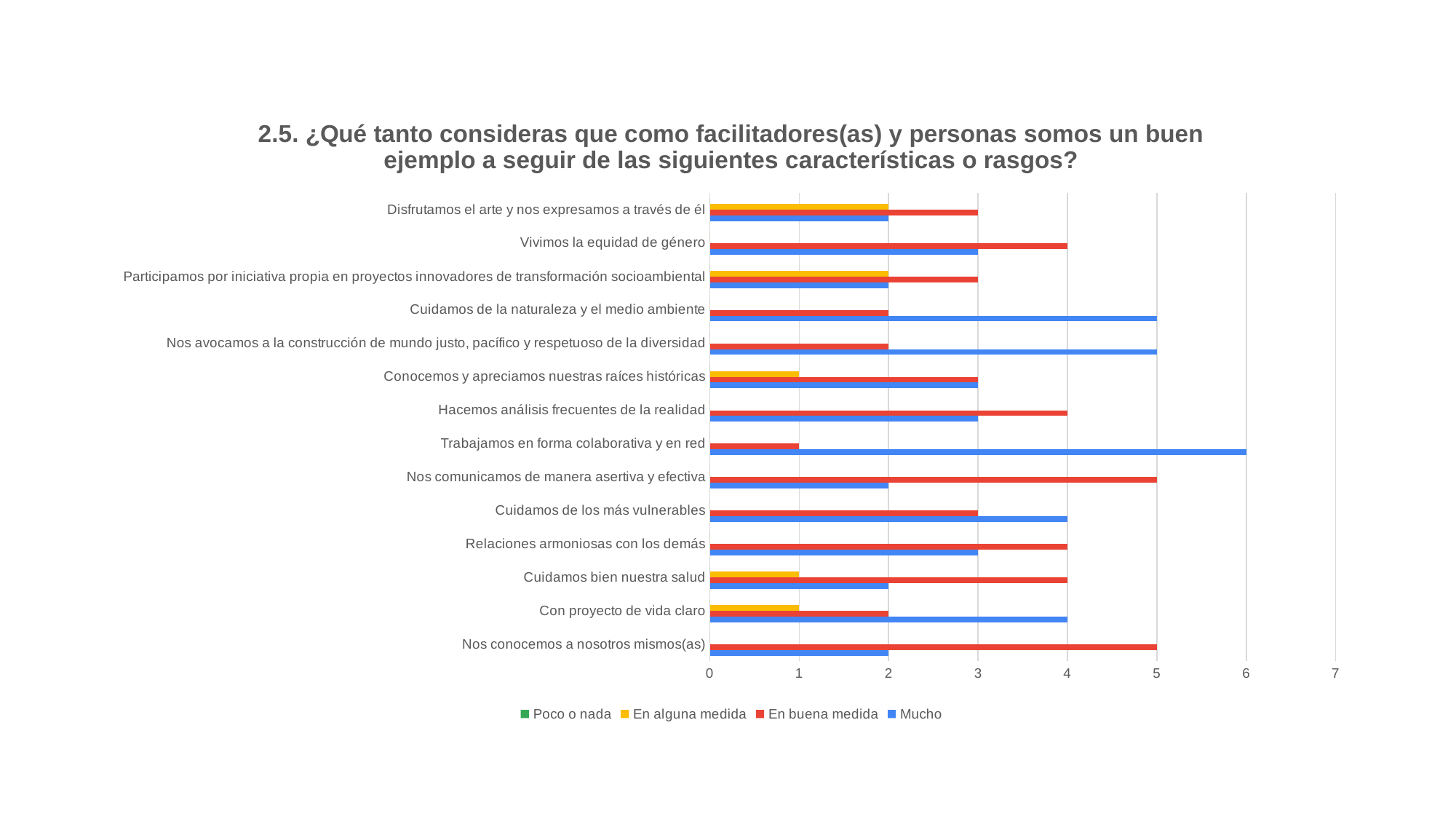
How many categories are plotted on the chart? 14 Which category has the lowest value for 'En buena medida'? Trabajamos en forma colaborativa y en red What is the value of 'Mucho' for 'Trabajamos en forma colaborativa y en red'? 6 What kind of chart is shown on the slide? Bar chart Which category has the highest value for 'Mucho'? Trabajamos en forma colaborativa y en red Which legend entry is shown in blue? Mucho What is the value of 'En alguna medida' for 'Disfrutamos el arte y nos expresamos a través de él'? 2 What is the difference between the 'Mucho' and 'En buena medida' values for 'Cuidamos de la naturaleza y el medio ambiente'? 3 Is the 'Mucho' value for 'Con proyecto de vida claro' greater or less than 3? greater What is the value of 'En buena medida' for 'Nos comunicamos de manera asertiva y efectiva'? 5 How many series does the legend list? 4 For 'Vivimos la equidad de género', which is larger: 'En buena medida' or 'Mucho'? En buena medida